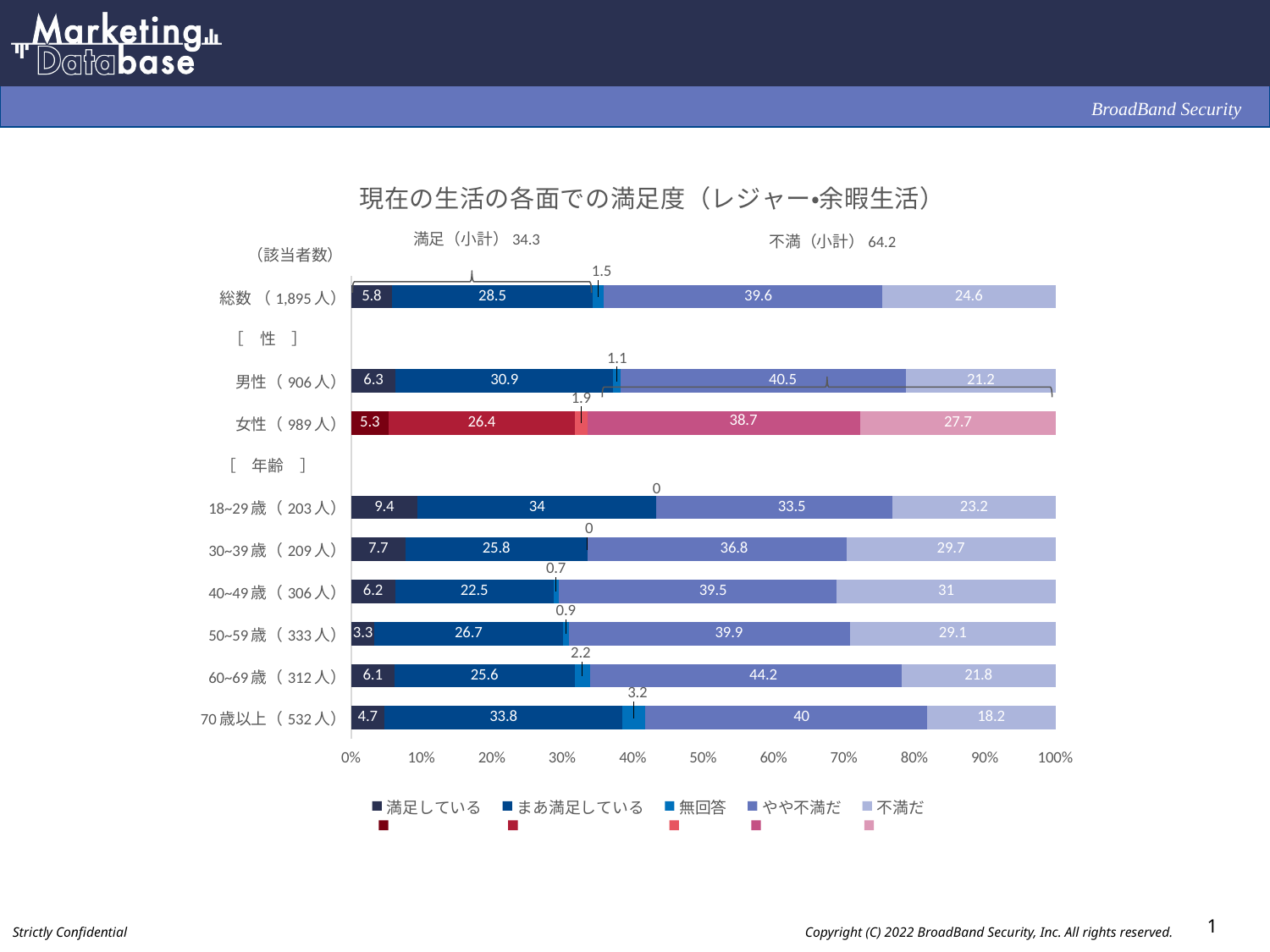
Which is larger, the 不満だ value for 40~49歳 or for 70歳以上? 40~49歳 Which category has the lowest value for 満足している? 50~59歳 How many labeled series does the legend list? 5 What is the 満足（小計） value shown above the chart? 34.3 What is the value of 不満だ for 女性? 27.7 What is the difference between the やや不満だ values for 男性 and 女性? 1.8 What is the value of やや不満だ for 60~69歳? 44.2 How many categories (bars) are plotted in the chart? 9 What is the value of まあ満足している for 総数? 28.5 What is the total of the stacked bar for 総数? 100 What kind of chart is shown on the slide? Stacked bar chart Which category has the highest value for 満足している? 18~29歳